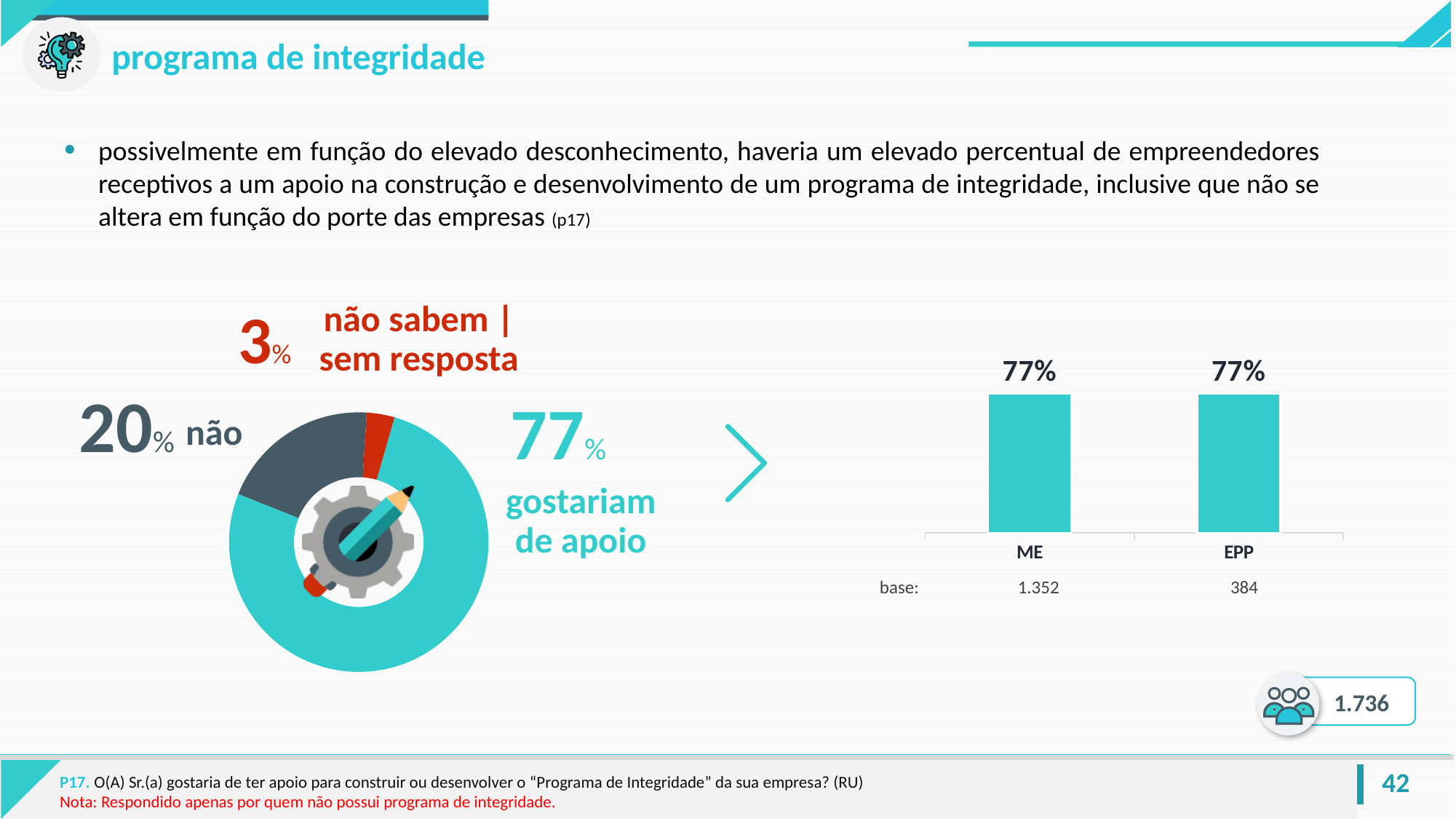
In the donut chart on the left, what percentage answered 'não'? 20% In the donut chart on the left, which response has the smallest share? não sabem | sem resposta In the donut chart on the left, which response has the largest share? gostariam de apoio In the bar chart on the right, what is the value for ME? 77% In the donut chart on the left, what percentage of respondents said they would like support (gostariam de apoio)? 77% In the donut chart on the left, what is the difference in percentage points between 'gostariam de apoio' and 'não'? 57 In the donut chart on the left, what percentage is 'não sabem | sem resposta'? 3% In the bar chart on the right, how many categories are shown? 2 In the bar chart on the right, what is the value for EPP? 77% In the donut chart on the left, how many slices are there? 3 In the bar chart on the right, what is the base (number of respondents) for ME? 1.352 What kind of chart is shown on the right side of the slide? bar chart